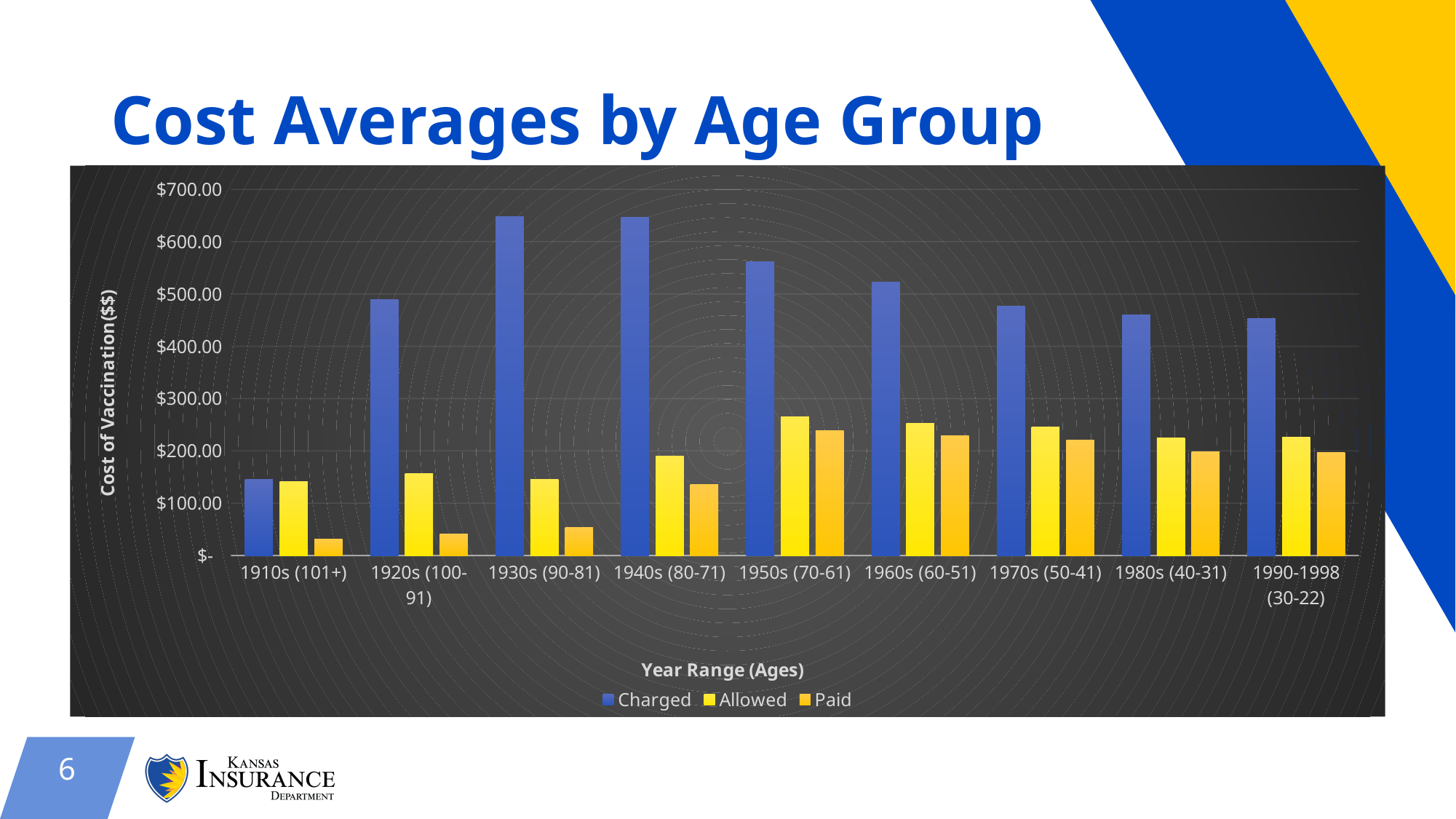
Which is larger, the Charged value for 1930s (90-81) or the Charged value for 1910s (101+)? 1930s (90-81) How many age-group categories are shown on the x axis? 9 Is the Paid value for 1940s (80-71) greater or less than $100.00? greater Which is larger, the Paid value for 1960s (60-51) or the Paid value for 1920s (100-91)? 1960s (60-51) Is the Charged value for 1930s (90-81) greater or less than $600.00? greater Is the Allowed value for 1950s (70-61) greater or less than $200.00? greater What is the title of the vertical axis? Cost of Vaccination($$) Which age group has the lowest Charged value? 1910s (101+) What kind of chart is shown on the slide? Bar chart Which age group has the lowest Paid value? 1910s (101+) How many series does the legend list? 3